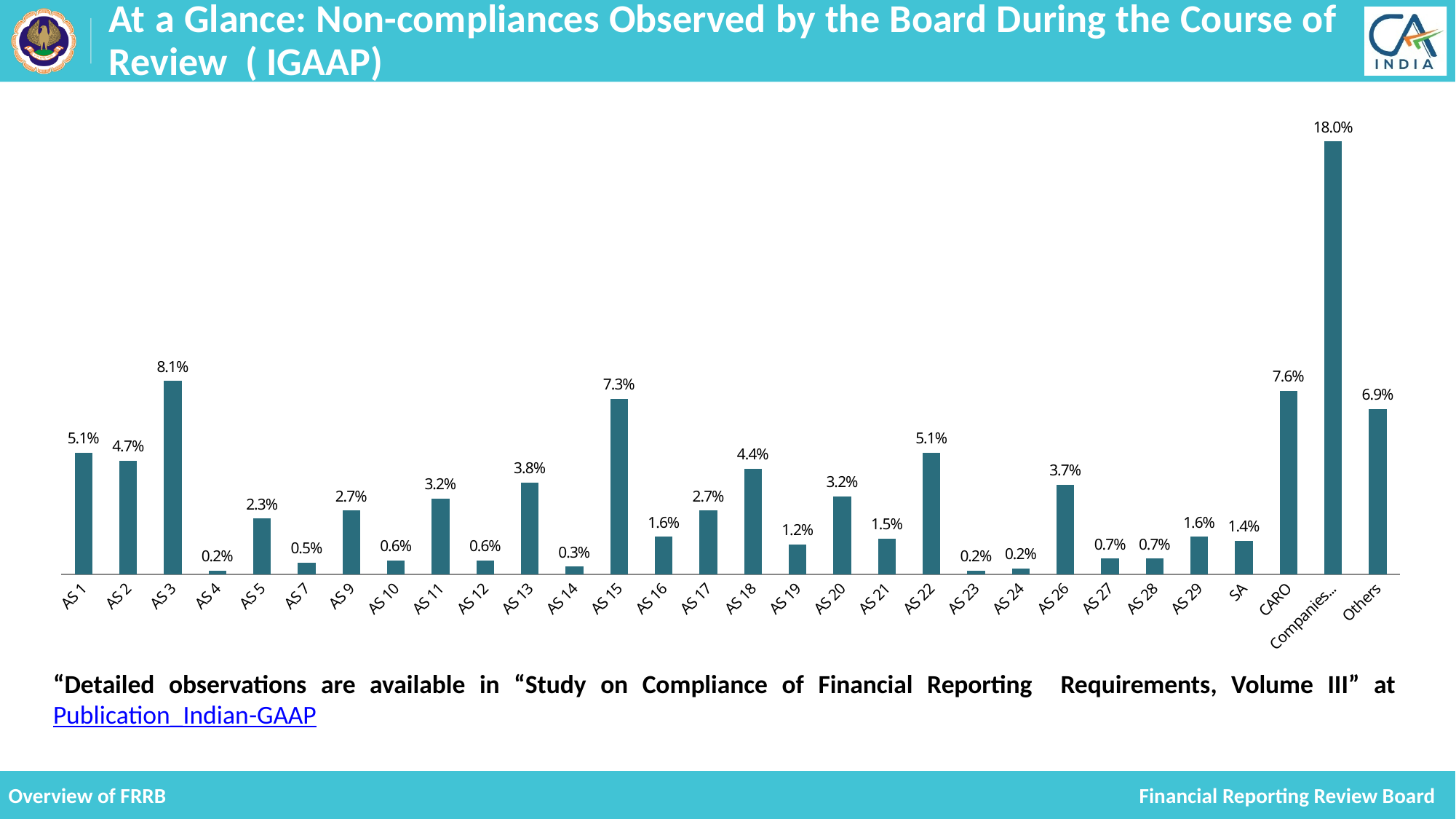
What kind of chart is shown on the slide? Bar chart What is the value shown for AS 18? 4.4% What is the value shown for AS 3? 8.1% Which has a larger value, AS 13 or AS 11? AS 13 What is the value shown for Others? 6.9% What is the difference between the values for Companies... and CARO? 10.4% What is the value shown for CARO? 7.6% What is the value shown for AS 15? 7.3% What is the difference between the values for AS 3 and AS 15? 0.8% Which has a larger value, AS 22 or AS 2? AS 22 How many categories are shown on the x axis of the chart? 30 Which category has the highest value in the chart? Companies...